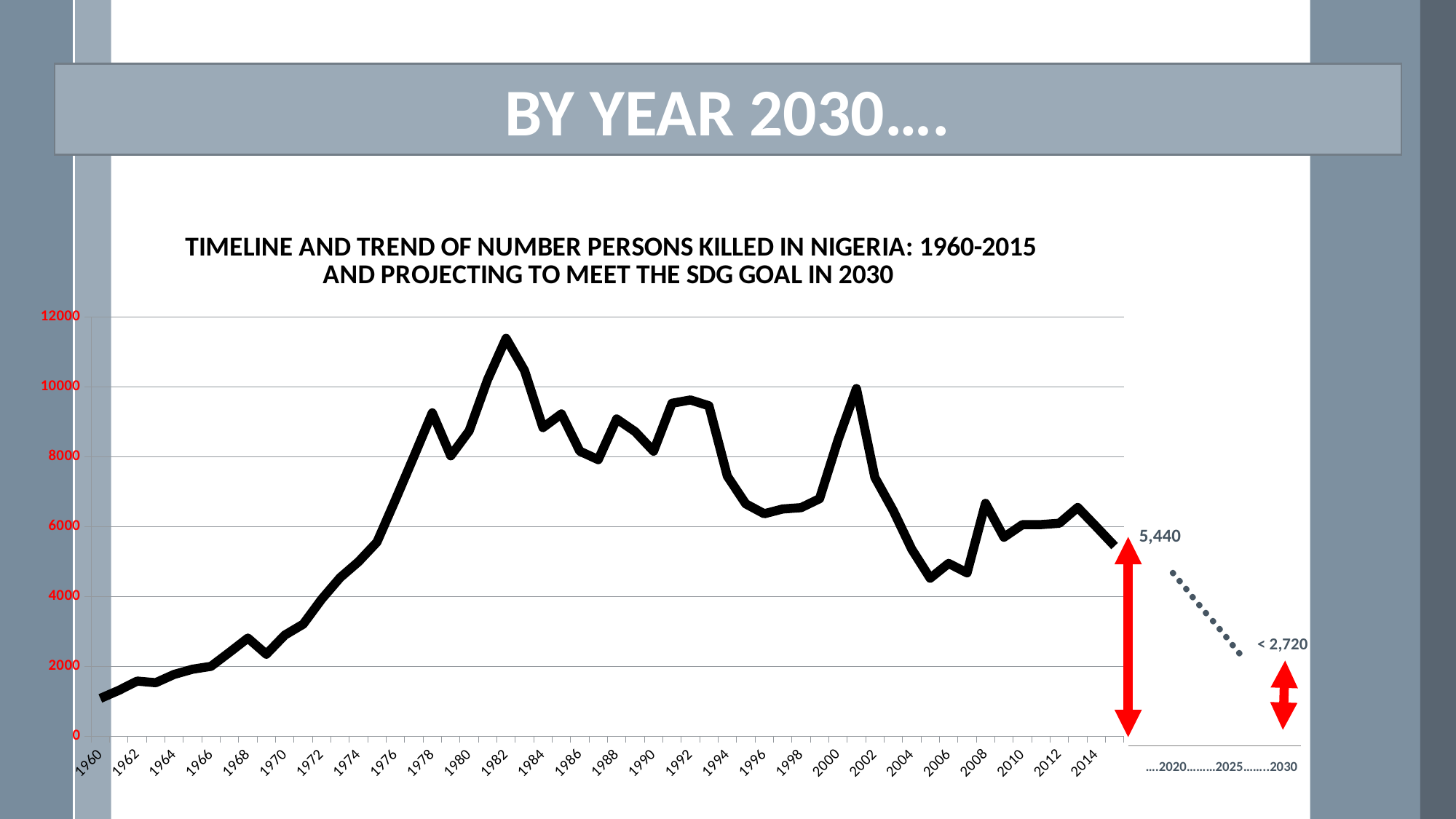
What is the highest tick value shown on the vertical axis? 12000 What value is labelled at the end of the line for 2015? 5,440 In which year does the number of persons killed reach its highest point? 1982 Is the value for 1992 greater or less than 8000? greater Is the value for 1982 greater or less than 10000? greater Is the value for 2005 greater or less than 6000? less Do the values rise or fall from 2001 to 2005? fall What value is labelled for the projected 2030 target? < 2,720 Do the values rise or fall from 1960 to 1982? rise Which year has the larger value, 1982 or 2001? 1982 What kind of chart is shown on the slide? line chart